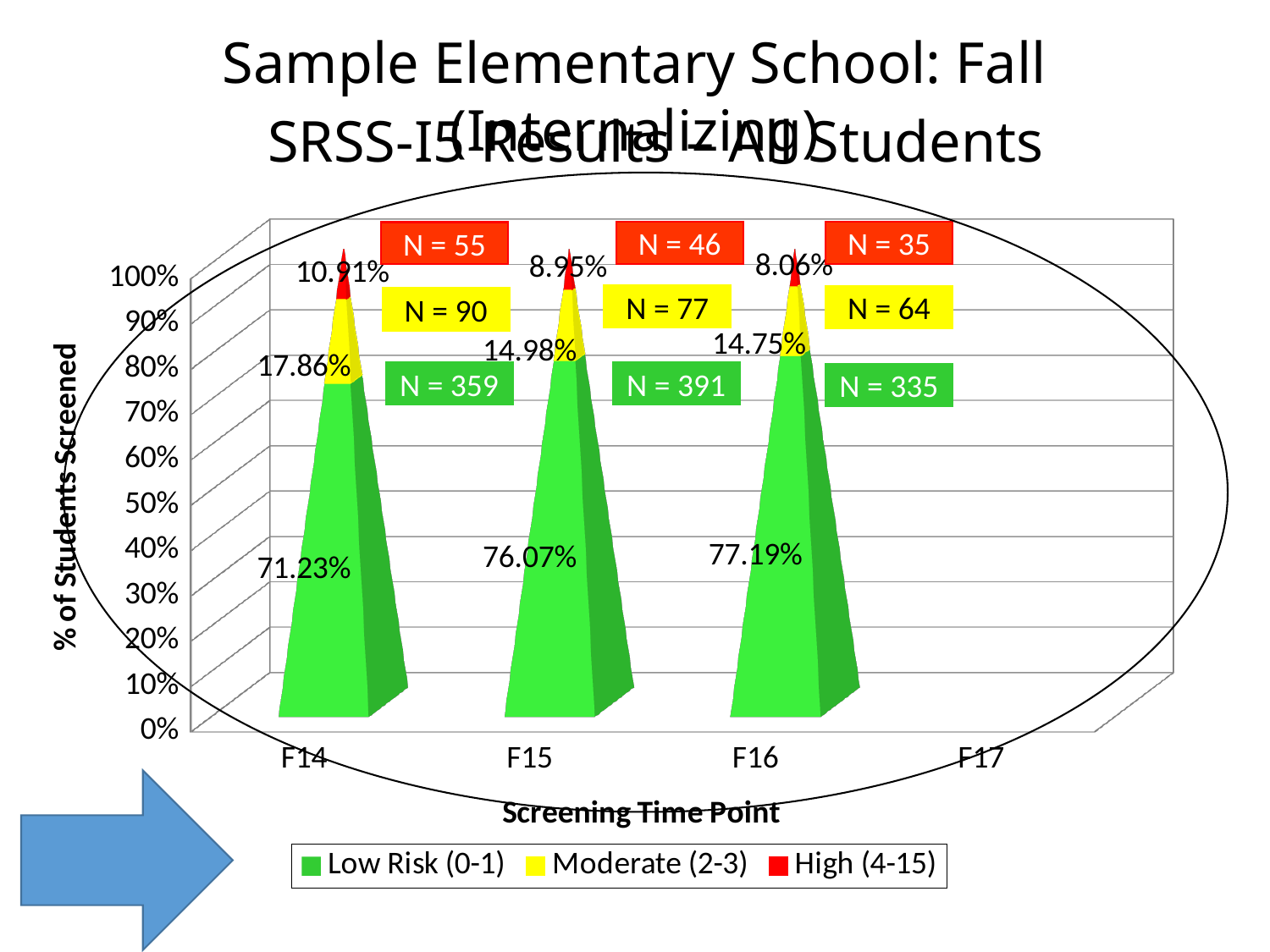
At which screening time point was the Low Risk (0-1) percentage highest? F16 Which time point had a larger Moderate (2-3) percentage, F14 or F16? F14 At which screening time point was the High (4-15) percentage lowest? F16 How many screening time points are labeled on the x axis? 4 What percentage of students were Moderate (2-3) at F15? 14.98% What is the title of the x axis? Screening Time Point What kind of chart is shown on the slide? Stacked bar chart What percentage of students were Low Risk (0-1) at F14? 71.23% By how many percentage points did the Low Risk (0-1) share increase from F14 to F16? 5.96 percentage points How many series does the legend list? 3 What percentage of students were High (4-15) at F16? 8.06% Does the Low Risk (0-1) percentage rise or fall from F14 to F16? Rises